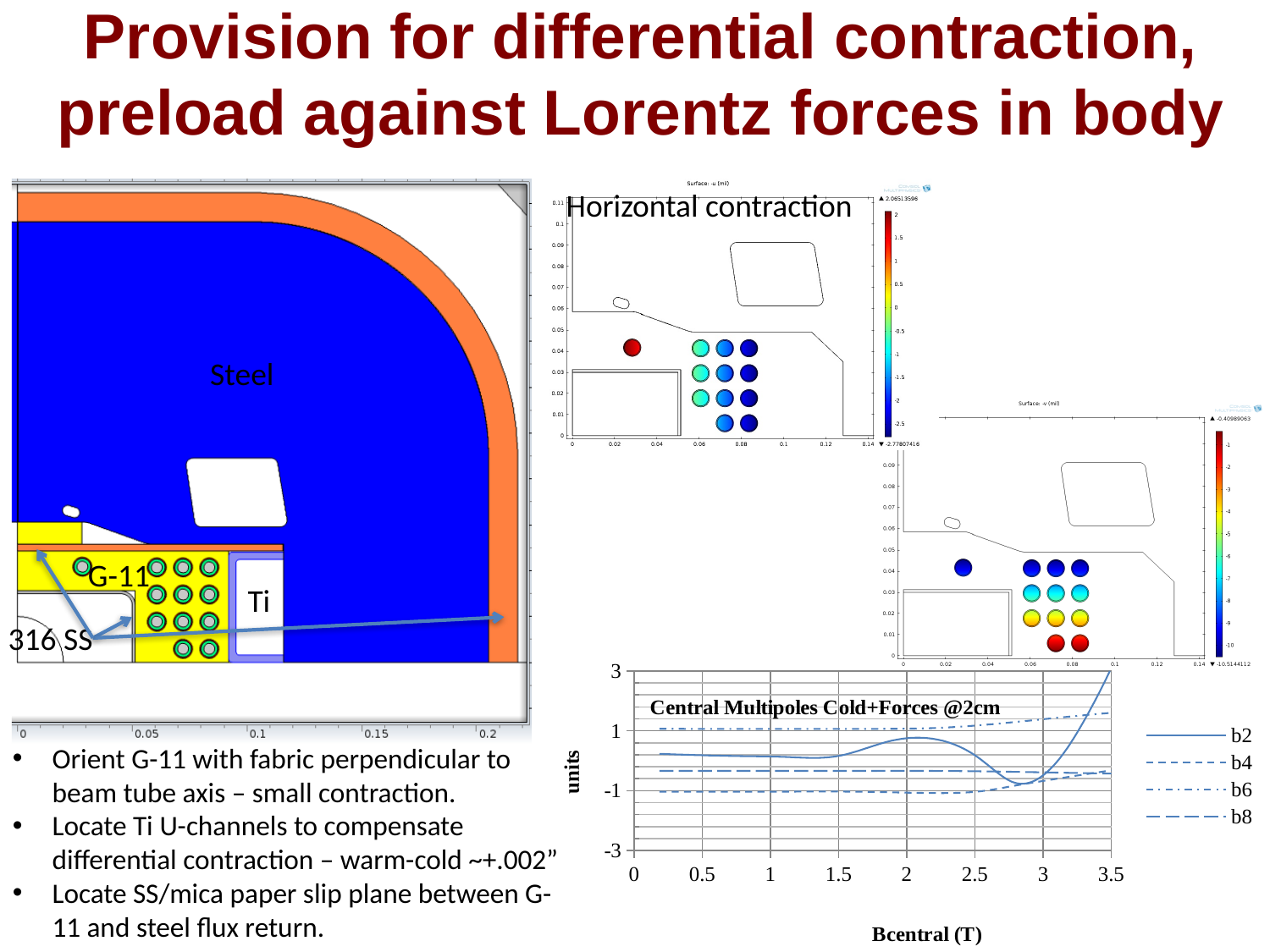
What are the series names in the legend of the 'Central Multipoles Cold+Forces @2cm' chart? b2, b4, b6, b8 In the 'Central Multipoles Cold+Forces @2cm' chart, which series has the lowest value at Bcentral = 1 T? b4 In the 'Central Multipoles Cold+Forces @2cm' chart, at Bcentral = 1 T, which is larger, b6 or b4? b6 In the 'Central Multipoles Cold+Forces @2cm' chart, is the value of b8 at Bcentral = 2 T greater or less than 0? less In the 'Central Multipoles Cold+Forces @2cm' chart, is the value of b6 at Bcentral = 0.5 T greater or less than 0? greater How many series does the legend of the 'Central Multipoles Cold+Forces @2cm' chart list? 4 What kind of chart is the 'Central Multipoles Cold+Forces @2cm' chart? line chart In the 'Central Multipoles Cold+Forces @2cm' chart, is the value of b4 at Bcentral = 1 T greater or less than 0? less What is the x-axis label of the 'Central Multipoles Cold+Forces @2cm' chart? Bcentral (T) In the 'Central Multipoles Cold+Forces @2cm' chart, does the b2 series rise or fall between Bcentral = 3 T and 3.5 T? rise In the 'Central Multipoles Cold+Forces @2cm' chart, which series has the highest value at Bcentral = 3.5 T? b2